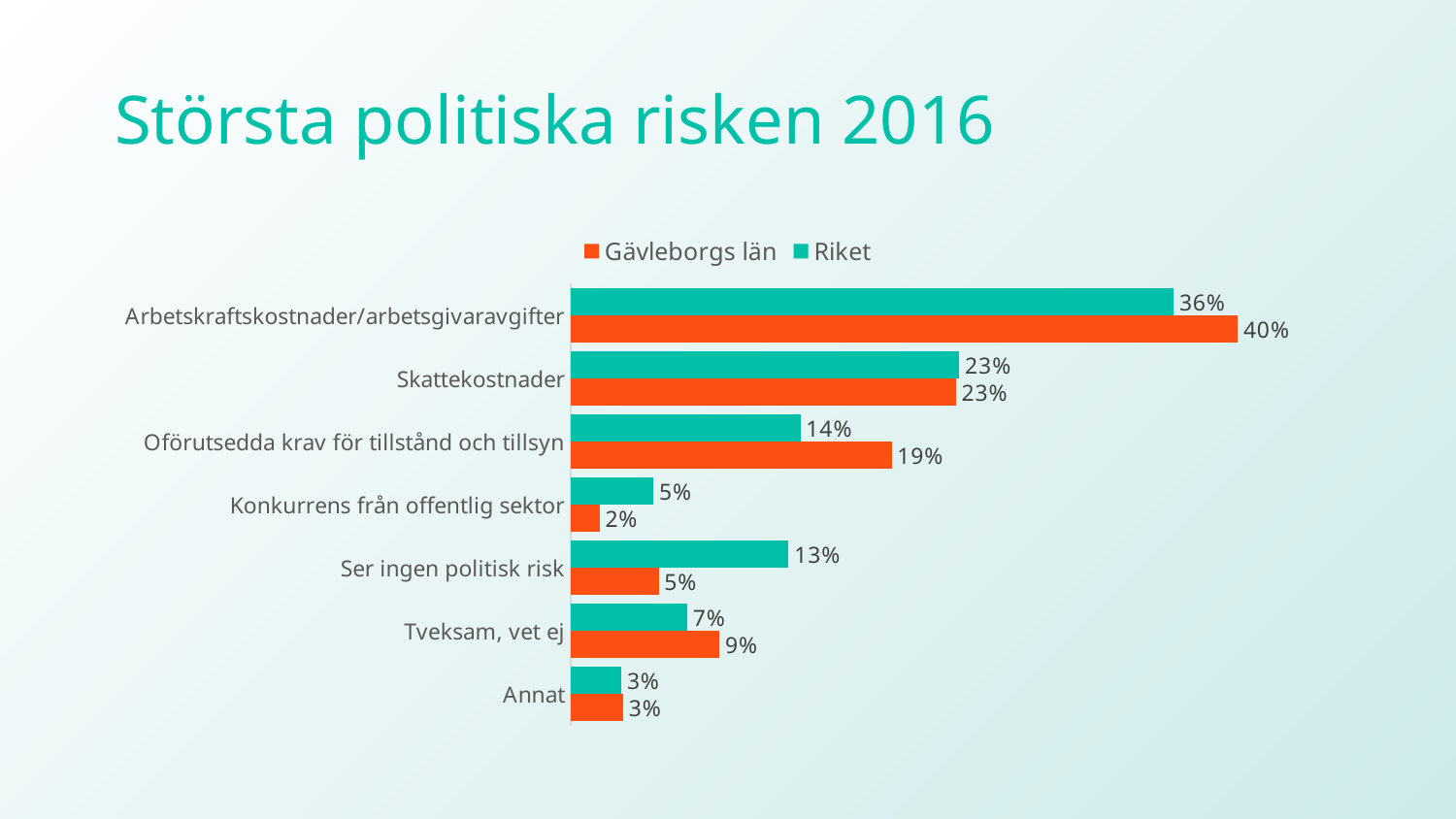
What is the value for Gävleborgs län for Arbetskraftskostnader/arbetsgivaravgifter? 40% What is the value for Riket for Oförutsedda krav för tillstånd och tillsyn? 14% Which category has the highest value for Riket? Arbetskraftskostnader/arbetsgivaravgifter Which category has the lowest value for Gävleborgs län? Konkurrens från offentlig sektor What is the difference between Gävleborgs län and Riket for Oförutsedda krav för tillstånd och tillsyn? 5% What kind of chart is shown on the slide? Bar chart How many categories are shown on the chart? 7 What is the value for Gävleborgs län for Ser ingen politisk risk? 5% How many series does the legend list? 2 Which is larger for Tveksam, vet ej: Gävleborgs län or Riket? Gävleborgs län What is the difference between Gävleborgs län and Riket for Ser ingen politisk risk? 8% What is the title of the slide? Största politiska risken 2016